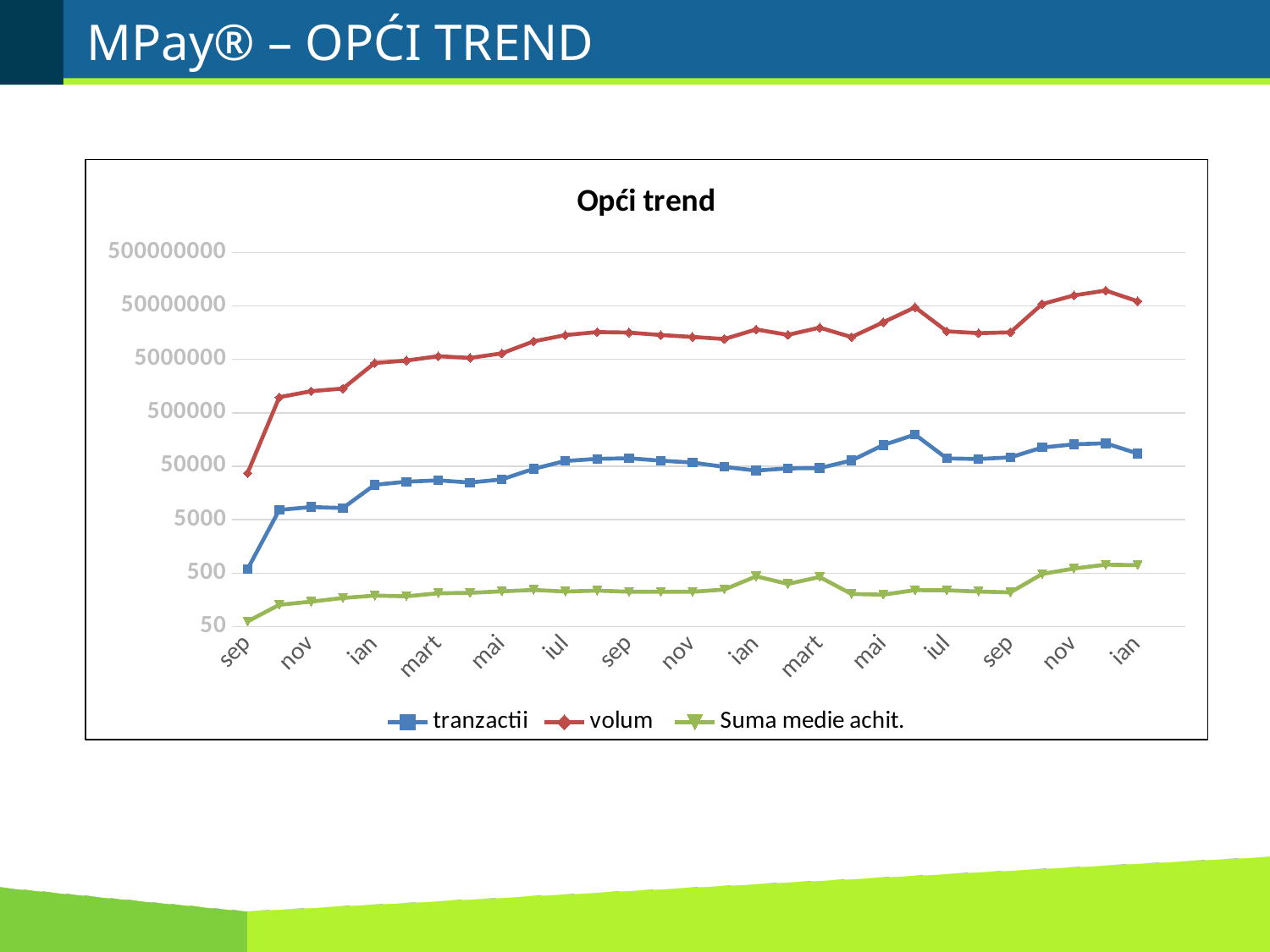
What kind of chart is shown on the slide? line chart What is the title of the chart? Opći trend Is the value of volum at the first iul greater or less than 5000000? greater Is the value of Suma medie achit. at the first ian greater or less than 500? less Is the value of tranzactii at the first nov greater or less than 5000? greater Do the tranzactii values generally rise or fall from the first sep to the last ian? rise Which series are listed in the legend? tranzactii, volum, Suma medie achit. Which series has the highest values across the chart? volum How many series does the legend list? 3 Which series has the lowest values across the chart? Suma medie achit. At the last ian, which is larger: volum or tranzactii? volum